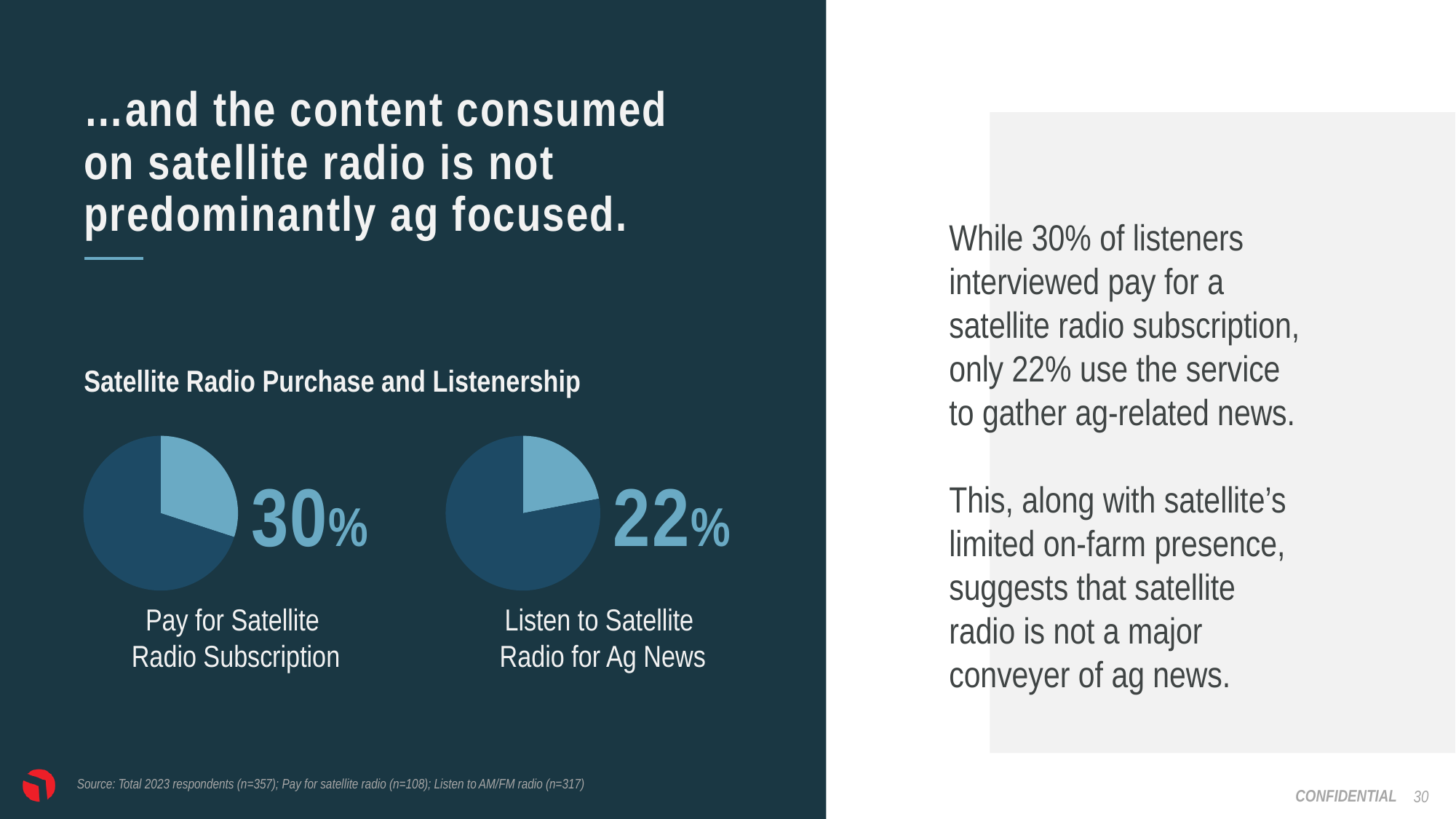
What percentage is shown for the 'Listen to Satellite Radio for Ag News' pie chart? 22% What percentage is shown for the 'Pay for Satellite Radio Subscription' pie chart? 30% How many pie charts are shown on the slide? 2 What kind of charts are used under the 'Satellite Radio Purchase and Listenership' heading? Pie charts What is the title above the pie charts? Satellite Radio Purchase and Listenership In the 'Pay for Satellite Radio Subscription' pie chart, what share of the pie does the highlighted light-blue slice represent? 30% In the 'Listen to Satellite Radio for Ag News' pie chart, what share of the pie does the highlighted light-blue slice represent? 22% Which of the two pie charts shows the higher percentage, 'Pay for Satellite Radio Subscription' or 'Listen to Satellite Radio for Ag News'? Pay for Satellite Radio Subscription What is the difference in percentage points between the 'Pay for Satellite Radio Subscription' value and the 'Listen to Satellite Radio for Ag News' value? 8 percentage points Which pie chart shows the lowest percentage? Listen to Satellite Radio for Ag News What colour is the highlighted slice in each pie chart? Light blue